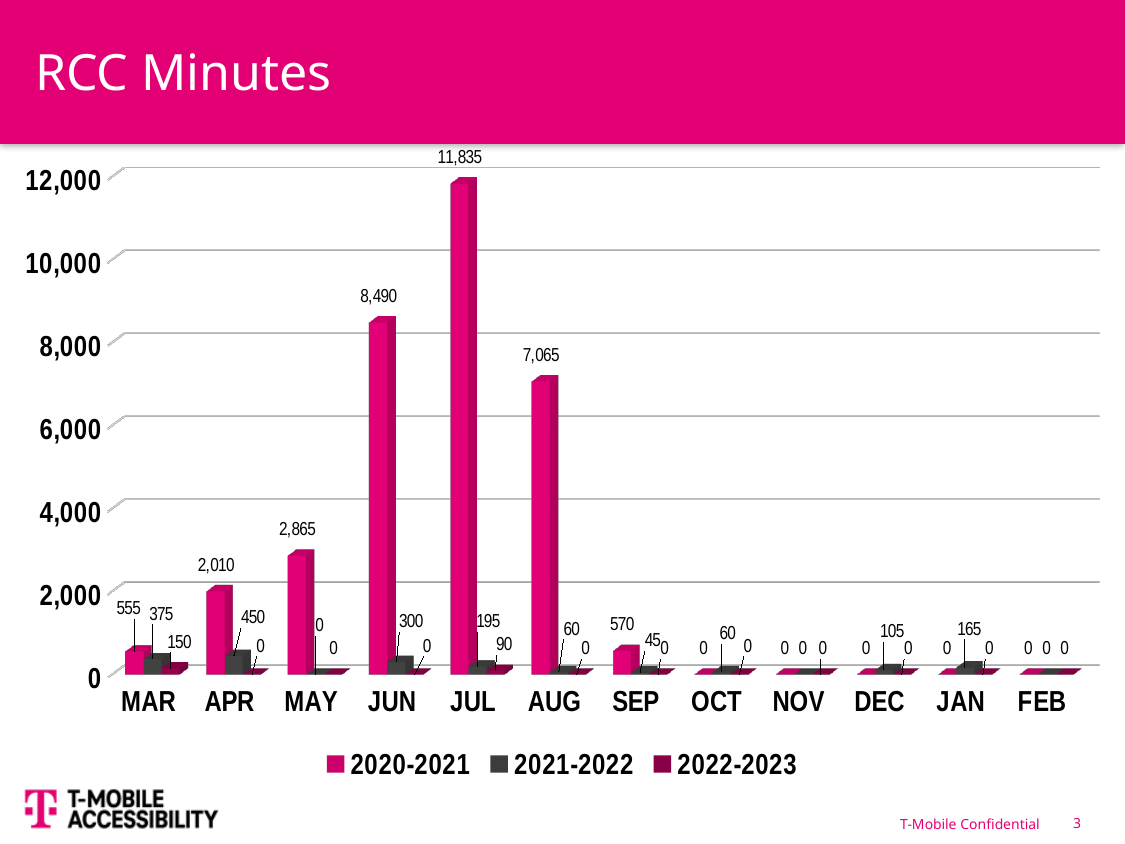
What kind of chart is shown on the slide? Bar chart What is the 2020-2021 value for JUL? 11,835 Which is larger, the 2020-2021 value for MAY or for APR? MAY How many series does the legend list? 3 Which month has the highest 2021-2022 value? APR What is the difference between the 2020-2021 values for JUN and AUG? 1,425 Which month has the highest 2020-2021 value? JUL What is the 2022-2023 value for MAR? 150 What is the 2021-2022 value for APR? 450 How many months are shown on the x axis? 12 What is the title of the chart? RCC Minutes What is the 2021-2022 value for JAN? 165